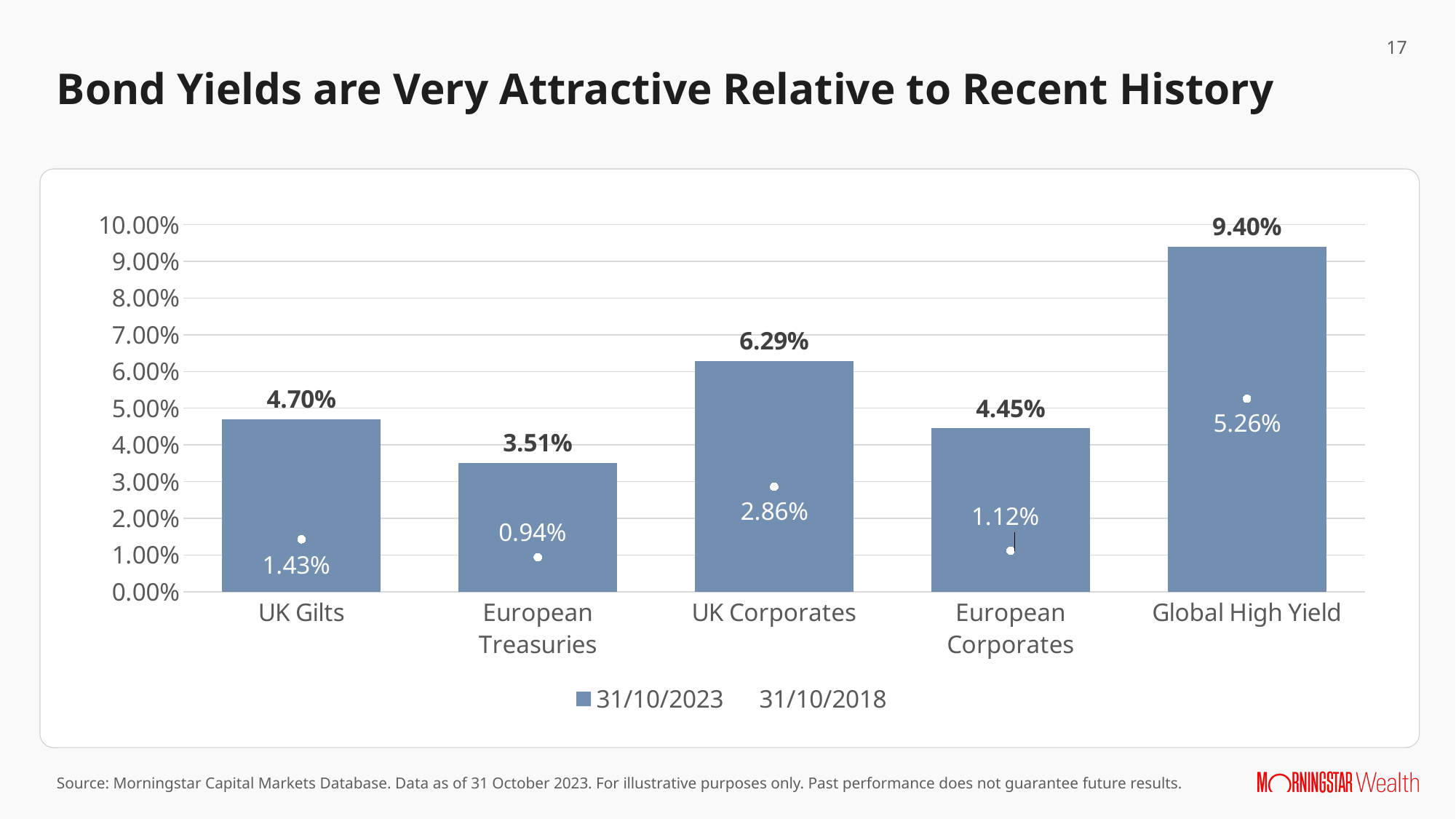
How many series does the legend list? 2 What is the 31/10/2018 value for European Treasuries? 0.94% Is the 31/10/2023 value for European Treasuries greater or less than 4.00%? less What is the 31/10/2018 value for Global High Yield? 5.26% Which category has the highest 31/10/2023 value? Global High Yield What is the title of the slide? Bond Yields are Very Attractive Relative to Recent History How many categories are shown on the x axis? 5 What is the difference between the 31/10/2023 and 31/10/2018 values for UK Gilts? 3.27% What kind of chart is shown on the slide? bar chart What is the 31/10/2023 value for UK Corporates? 6.29% Which is larger: the 31/10/2023 value for UK Gilts or for European Corporates? UK Gilts Which category has the lowest 31/10/2018 value? European Treasuries